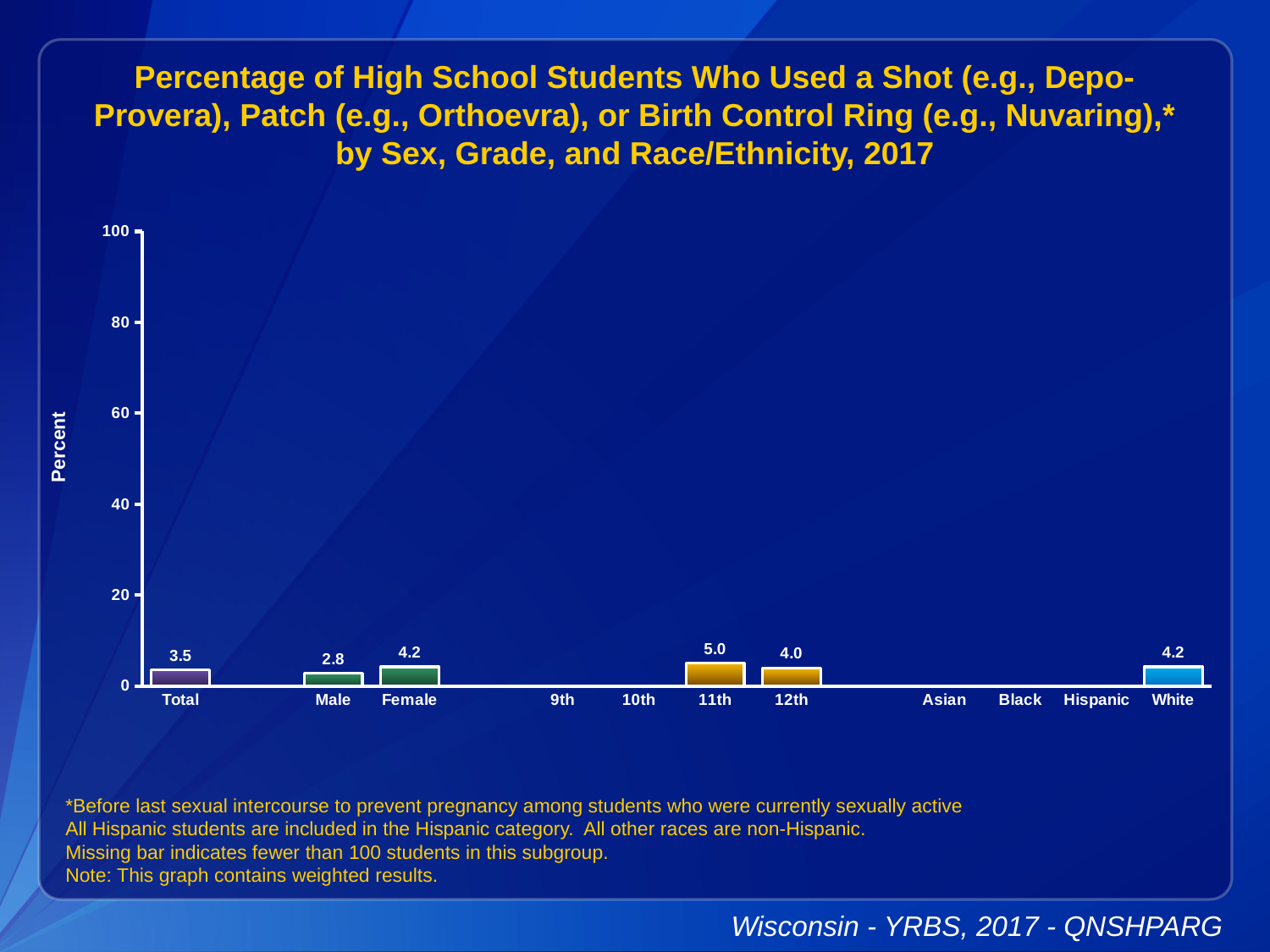
What is the value for 11th grade? 5.0 Which category has the highest value? 11th Which is larger, the value for Female or the value for Male? Female Which category with a bar has the lowest value? Male What is the value for Male? 2.8 What is the difference between the Female and Male values? 1.4 Is the value for 12th grade greater or less than 20? less What is the difference between the 11th and 12th grade values? 1.0 How many categories are labeled on the x axis? 11 What kind of chart is shown on the slide? bar chart What is the value for White students? 4.2 What is the value for Total? 3.5